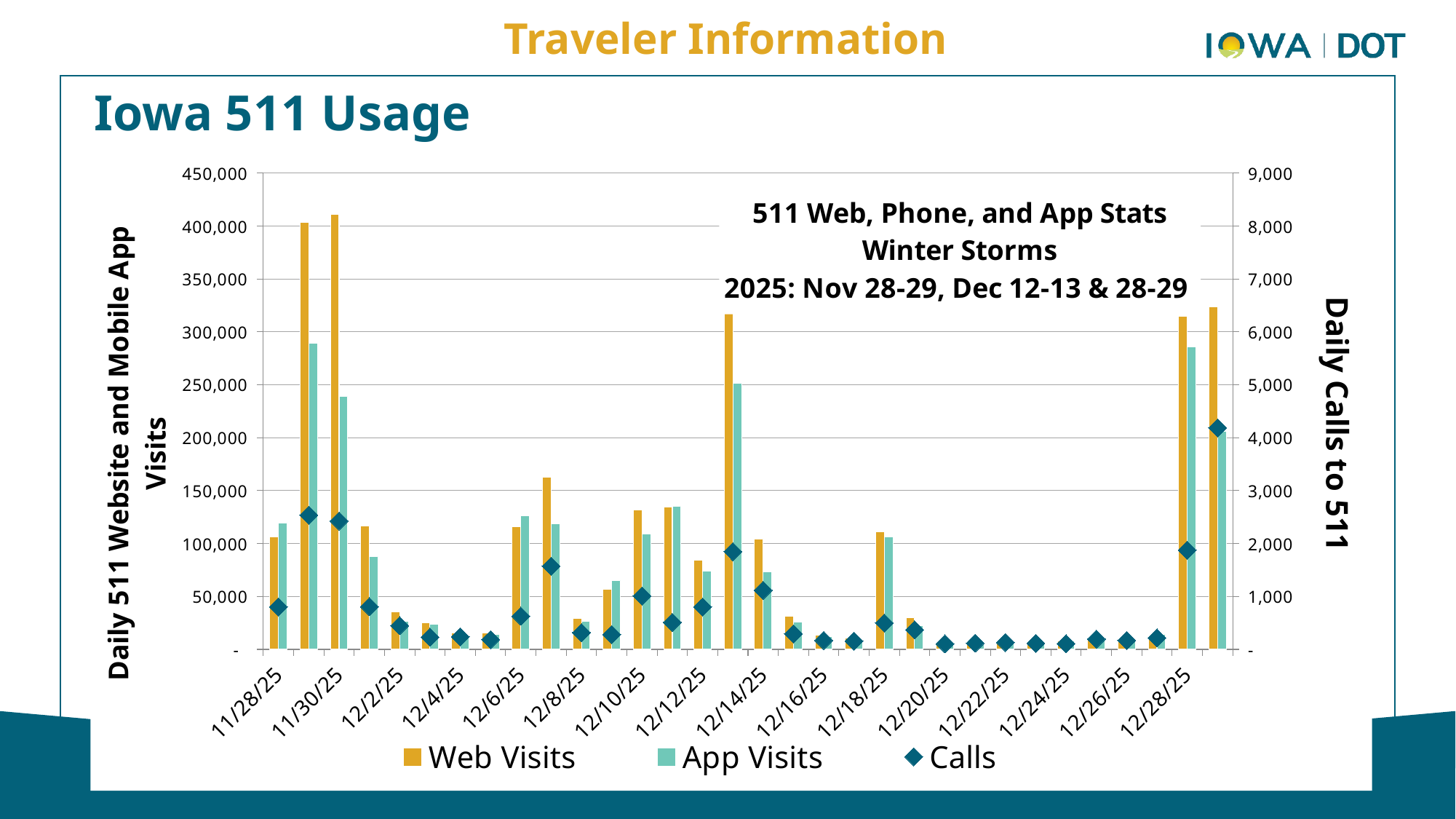
On 11/29/25, which is larger: Web Visits or App Visits? Web Visits Is the value for Calls on 11/29/25 greater or less than 2,000? greater Is the value for Calls on 12/29/25 greater or less than 4,000? greater Do Web Visits rise or fall from 11/30/25 to 12/4/25? Fall What is the title of the right-hand vertical axis? Daily Calls to 511 On which date are Calls to 511 highest? 12/29/25 Is the value for Web Visits on 12/7/25 greater or less than 150,000? greater What kind of chart is used to show Web Visits and App Visits? Bar chart On 12/6/25, which is larger: Web Visits or App Visits? App Visits How many series does the legend list? 3